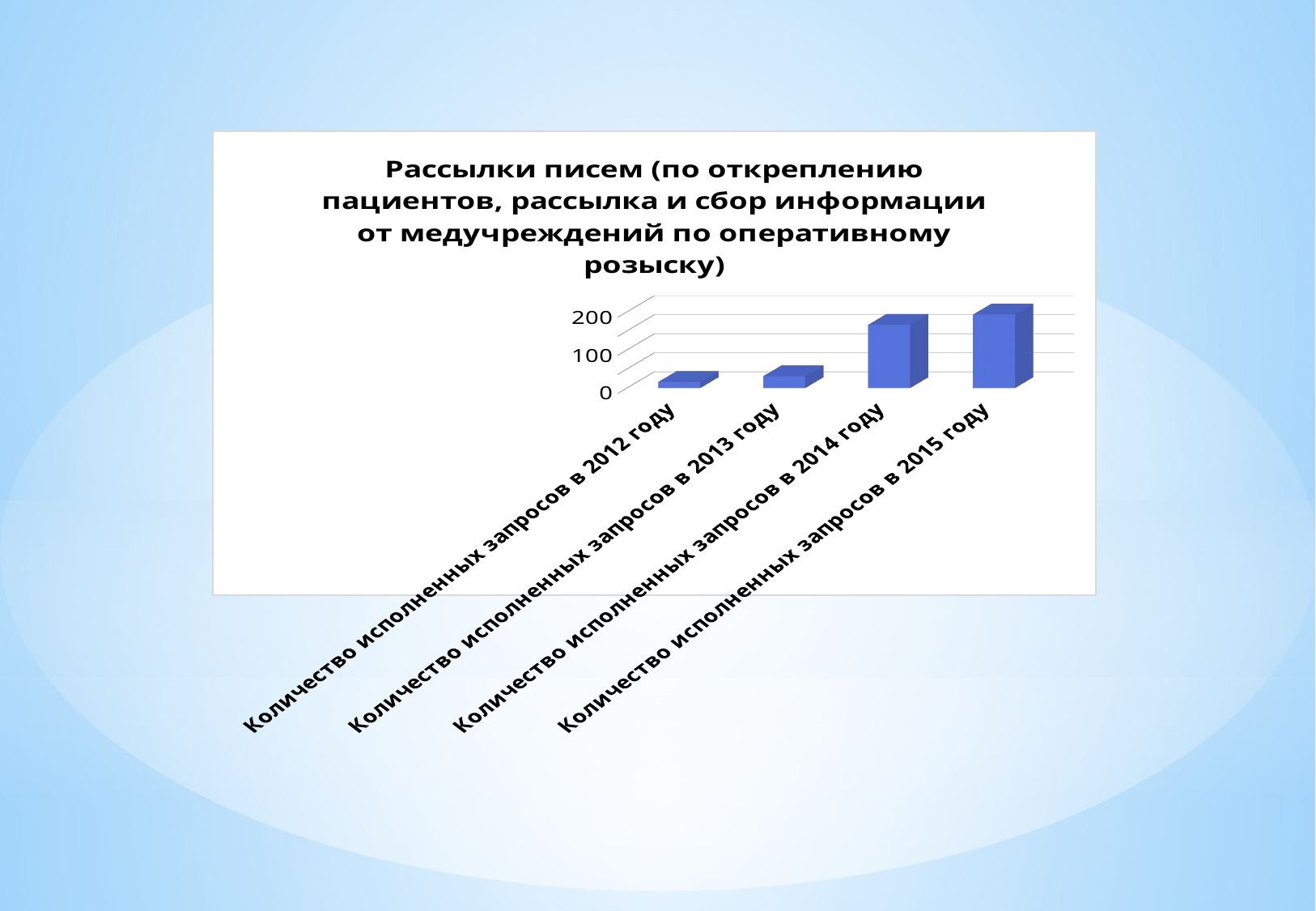
Is the value for Количество исполненных запросов в 2013 году greater or less than 100? less Is the value for Количество исполненных запросов в 2015 году greater or less than 100? greater Is the value for Количество исполненных запросов в 2012 году greater or less than 100? less What kind of chart is shown on the slide? bar chart Do the values rise or fall from 2012 to 2015 along the x axis? rise Which category has the highest value in the chart? Количество исполненных запросов в 2015 году Which is larger: the value for 2013 or the value for 2014? 2014 What is the highest tick value shown on the vertical axis? 200 Which category has the lowest value in the chart? Количество исполненных запросов в 2012 году What colour are the bars in the chart? blue How many categories (bars) are plotted in the chart? 4